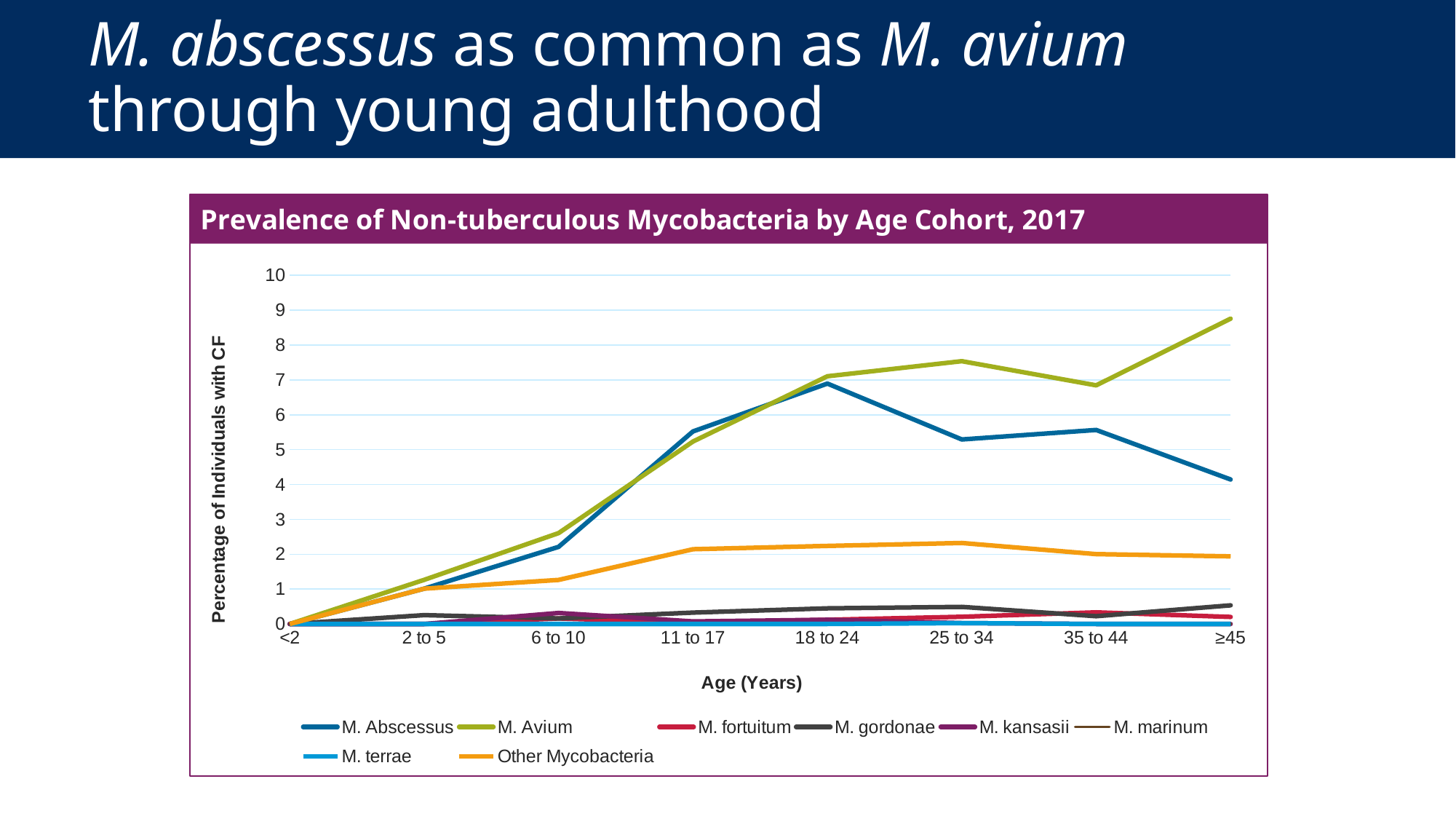
In the ≥45 cohort, which is larger: M. Avium or M. Abscessus? M. Avium Does the M. Abscessus line rise or fall from the 18 to 24 cohort to the ≥45 cohort? fall Is the value for Other Mycobacteria in the 18 to 24 cohort greater or less than 2? greater What kind of chart is shown on the slide? line chart In which age cohort is the M. Avium prevalence highest? ≥45 Is the value for M. Abscessus in the 25 to 34 cohort greater or less than 5? greater How many series does the legend list? 8 Is the value for M. Avium in the ≥45 cohort greater or less than 8? greater In which age cohort is the M. Avium prevalence lowest? <2 What is the label of the y axis? Percentage of Individuals with CF In which age cohort is the M. Abscessus prevalence highest? 18 to 24 How many age cohorts are shown on the x axis? 8